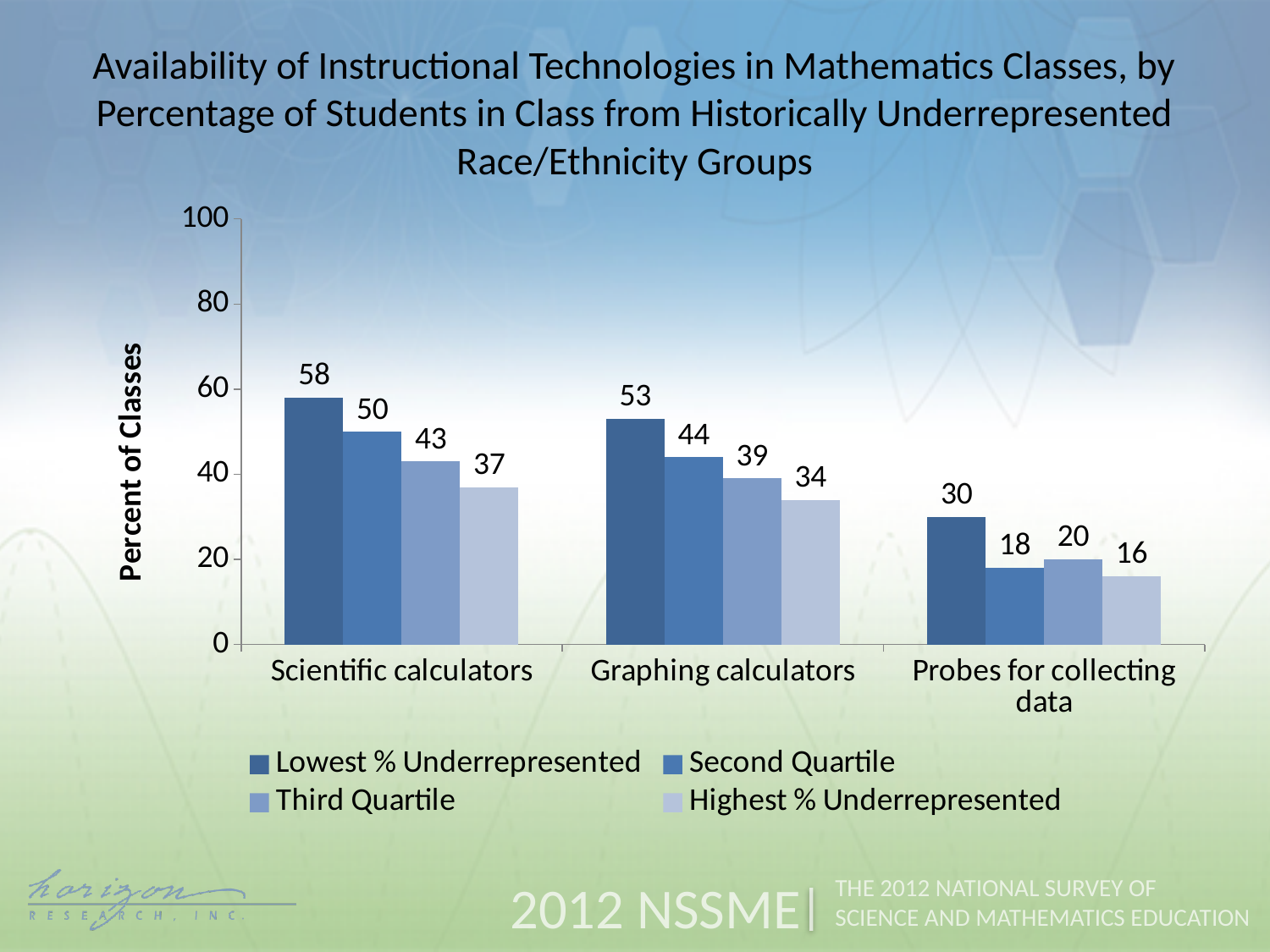
What is the value for Graphing calculators in the Third Quartile series? 39 How many series does the legend list? 4 How many categories are shown on the x axis? 3 What is the value for Scientific calculators in the Lowest % Underrepresented series? 58 Which category has the lowest value in the Lowest % Underrepresented series? Probes for collecting data What is the label of the y axis? Percent of Classes Which is larger for Probes for collecting data: the Second Quartile value or the Third Quartile value? Third Quartile Which category has the highest value in the Second Quartile series? Scientific calculators What is the value for Probes for collecting data in the Highest % Underrepresented series? 16 What is the difference between the Lowest % Underrepresented and Highest % Underrepresented values for Scientific calculators? 21 Is the Lowest % Underrepresented value for Graphing calculators greater or less than 40? greater What kind of chart is shown on the slide? Bar chart